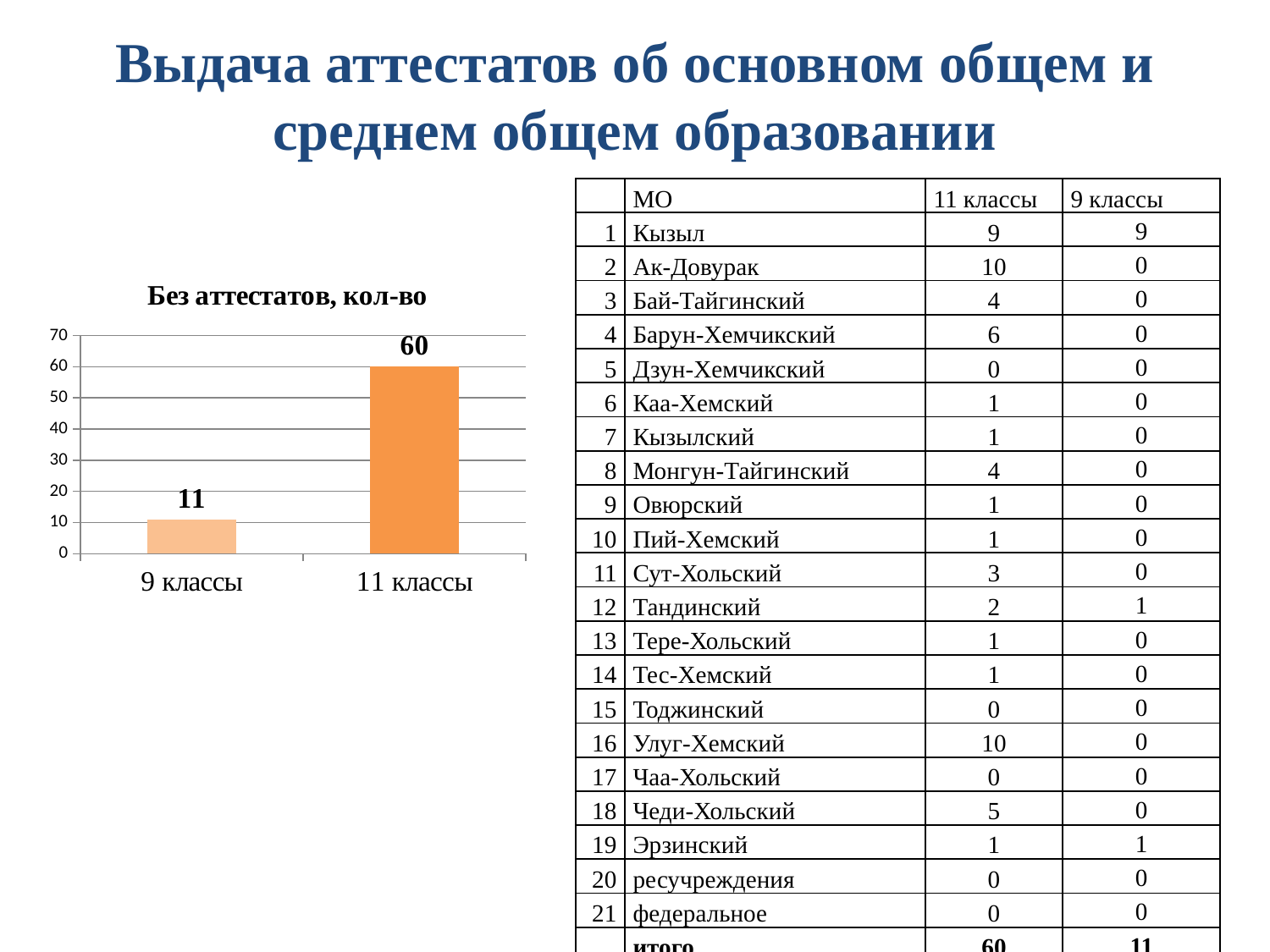
What kind of chart is shown on the slide? bar chart How many categories are shown in the chart 'Без аттестатов, кол-во'? 2 What is the value for 11 классы in the chart 'Без аттестатов, кол-во'? 60 What is the difference between the values for 11 классы and 9 классы in the chart? 49 Is the value for 11 классы greater or less than 50? greater Is the value for 9 классы greater or less than 20? less Which is larger in the chart: the value for 9 классы or for 11 классы? 11 классы Which category has the lowest value in the chart 'Без аттестатов, кол-во'? 9 классы What is the maximum value shown on the vertical axis of the chart? 70 What is the title of the chart on the slide? Без аттестатов, кол-во What is the value for 9 классы in the chart 'Без аттестатов, кол-во'? 11 Which category has the highest value in the chart 'Без аттестатов, кол-во'? 11 классы